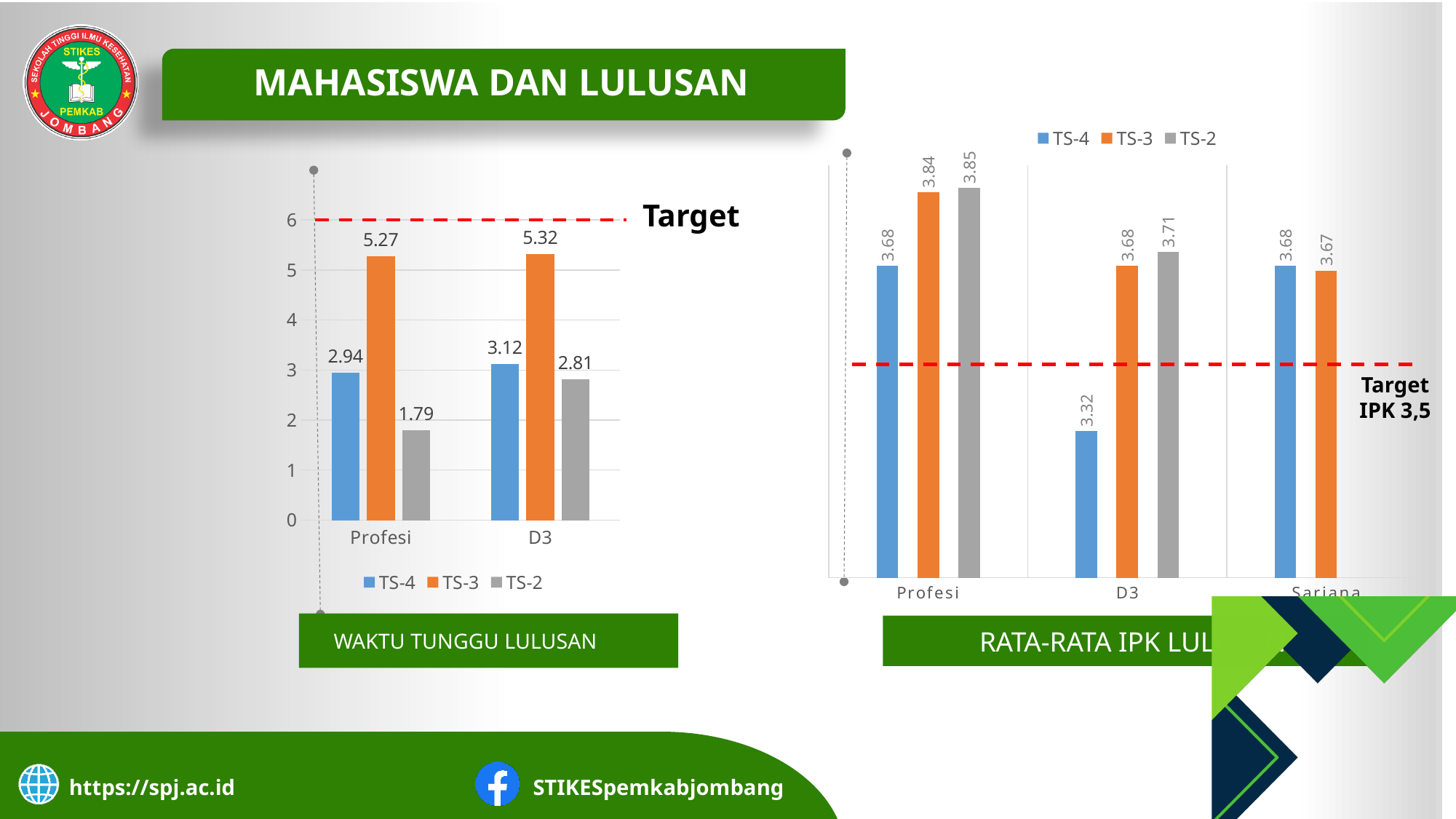
In the left chart (WAKTU TUNGGU LULUSAN), which series has the lowest value for Profesi? TS-2 In the left chart (WAKTU TUNGGU LULUSAN), what is the TS-3 value for Profesi? 5.27 In the right chart (RATA-RATA IPK), what is the TS-4 value for D3? 3.32 In the right chart (RATA-RATA IPK), is the TS-4 value for D3 greater or less than the target IPK of 3.5? less In the left chart (WAKTU TUNGGU LULUSAN), what is the TS-2 value for D3? 2.81 In the left chart (WAKTU TUNGGU LULUSAN), what is the difference between the TS-3 and TS-4 values for D3? 2.20 In the right chart (RATA-RATA IPK), what is the difference between the TS-2 and TS-4 values for Profesi? 0.17 In the left chart (WAKTU TUNGGU LULUSAN), how many series does the legend list? 3 In the right chart (RATA-RATA IPK), how many categories are shown on the x axis? 3 What kind of chart is the right chart (RATA-RATA IPK)? bar chart In the left chart (WAKTU TUNGGU LULUSAN), is the TS-3 value for D3 greater or less than the target line at 6? less In the right chart (RATA-RATA IPK), which series has the highest value for Profesi? TS-2